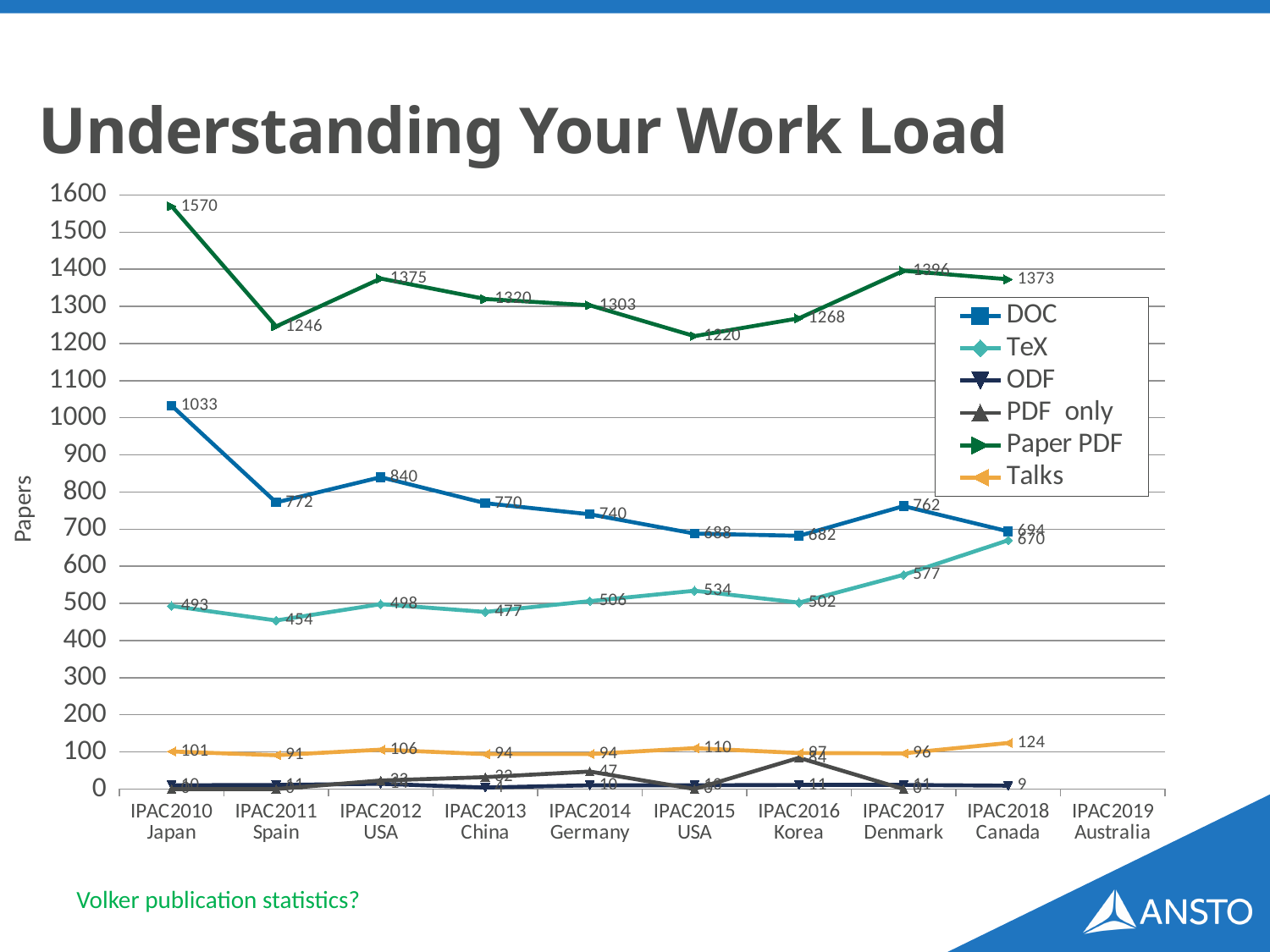
What is the TeX value at IPAC2018 Canada? 670 What is the title of the vertical axis? Papers What is the DOC value at IPAC2012 USA? 840 At which conference is the Paper PDF series lowest? IPAC2015 USA What is the difference between the Paper PDF values at IPAC2010 Japan and IPAC2011 Spain? 324 What is the difference between the DOC values at IPAC2010 Japan and IPAC2018 Canada? 339 At IPAC2018 Canada, which is larger, DOC or TeX? DOC What is the Paper PDF value at IPAC2010 Japan? 1570 How many series does the legend list? 6 What is the Talks value at IPAC2018 Canada? 124 What kind of chart is shown on the slide? Line chart At which conference is the Paper PDF series highest? IPAC2010 Japan